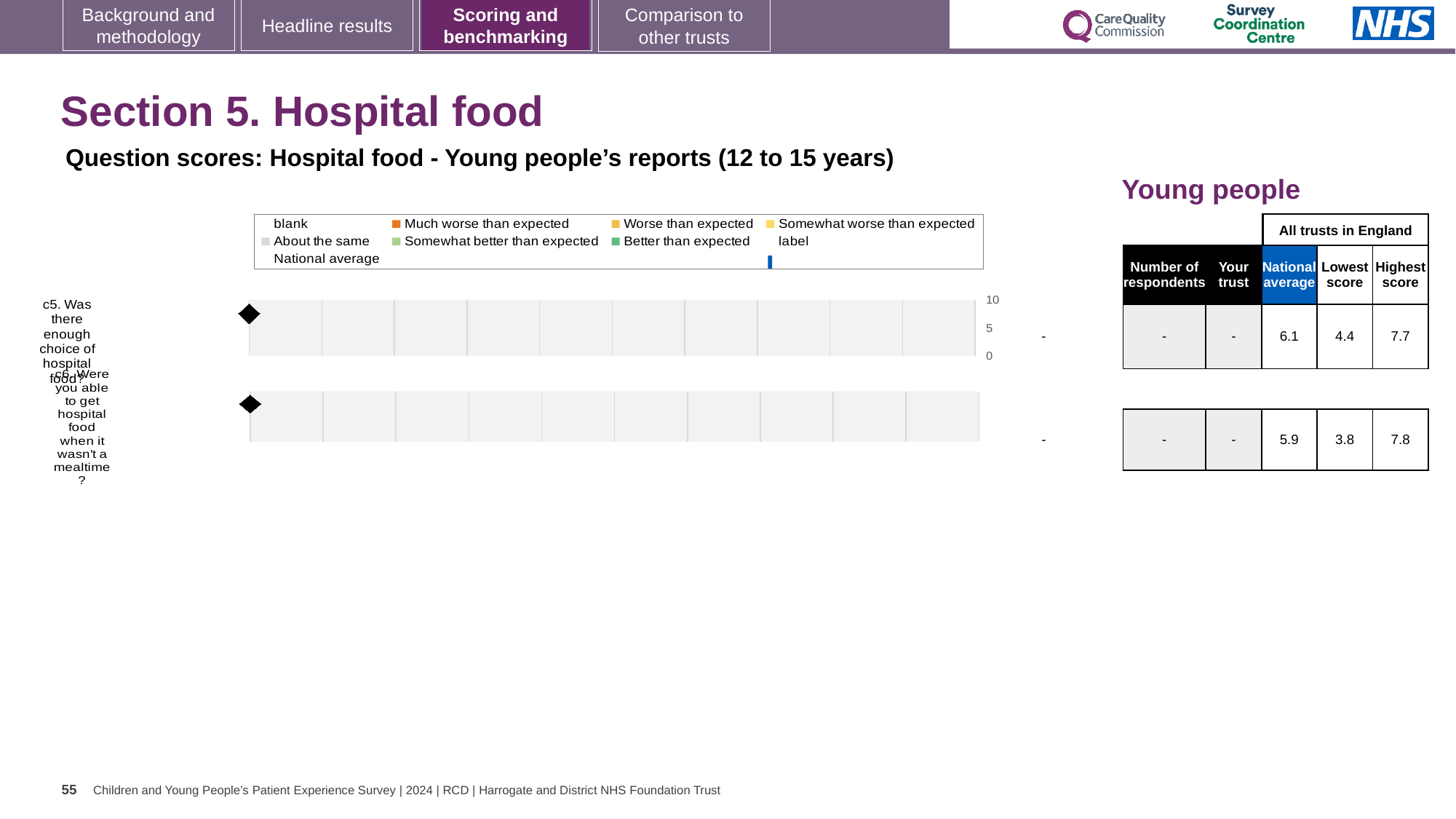
Which legend entry is shown in orange on the chart? Much worse than expected In the table next to the chart, which question has the higher national average, c5 or c6? c5 In the table next to the chart, what is the national average for c5 (Was there enough choice of hospital food?)? 6.1 In the table next to the chart, what is the difference between the highest and lowest score for c6? 4.0 What kind of chart is shown on the slide? bar chart In the table next to the chart, what is the difference between the highest and lowest score for c5? 3.3 In the table next to the chart, what is the lowest score for c5? 4.4 In the table next to the chart, what is the highest score for c6? 7.8 In the table next to the chart, what is the national average for c6 (Were you able to get hospital food when it wasn't a mealtime?)? 5.9 What is the highest value shown on the chart's axis? 10 How many question categories are plotted on the chart? 2